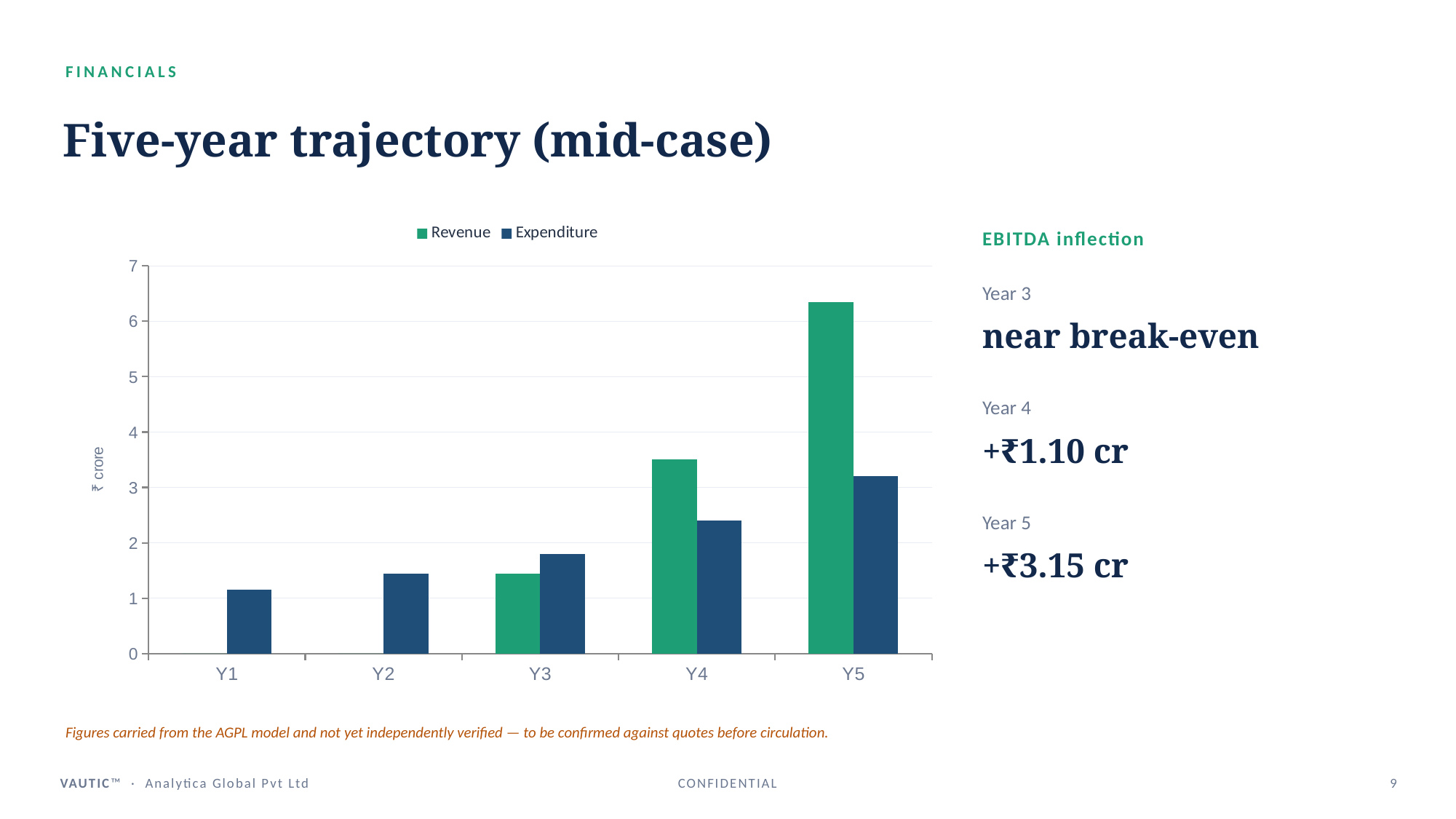
Is the Expenditure value for Y3 greater or less than 2? less What kind of chart is shown on the slide? bar chart Is the Revenue value for Y5 greater or less than 6? greater In Y4, which is larger, Revenue or Expenditure? Revenue How many year categories are shown on the x axis of the chart? 5 What is the label on the vertical axis of the chart? ₹ crore How many series does the chart legend list? 2 In Y3, which is larger, Revenue or Expenditure? Expenditure In which year is the Revenue bar highest? Y5 In which year is the Expenditure bar highest? Y5 Does Expenditure rise or fall from Y1 to Y5? rise In which year is the Expenditure bar lowest? Y1